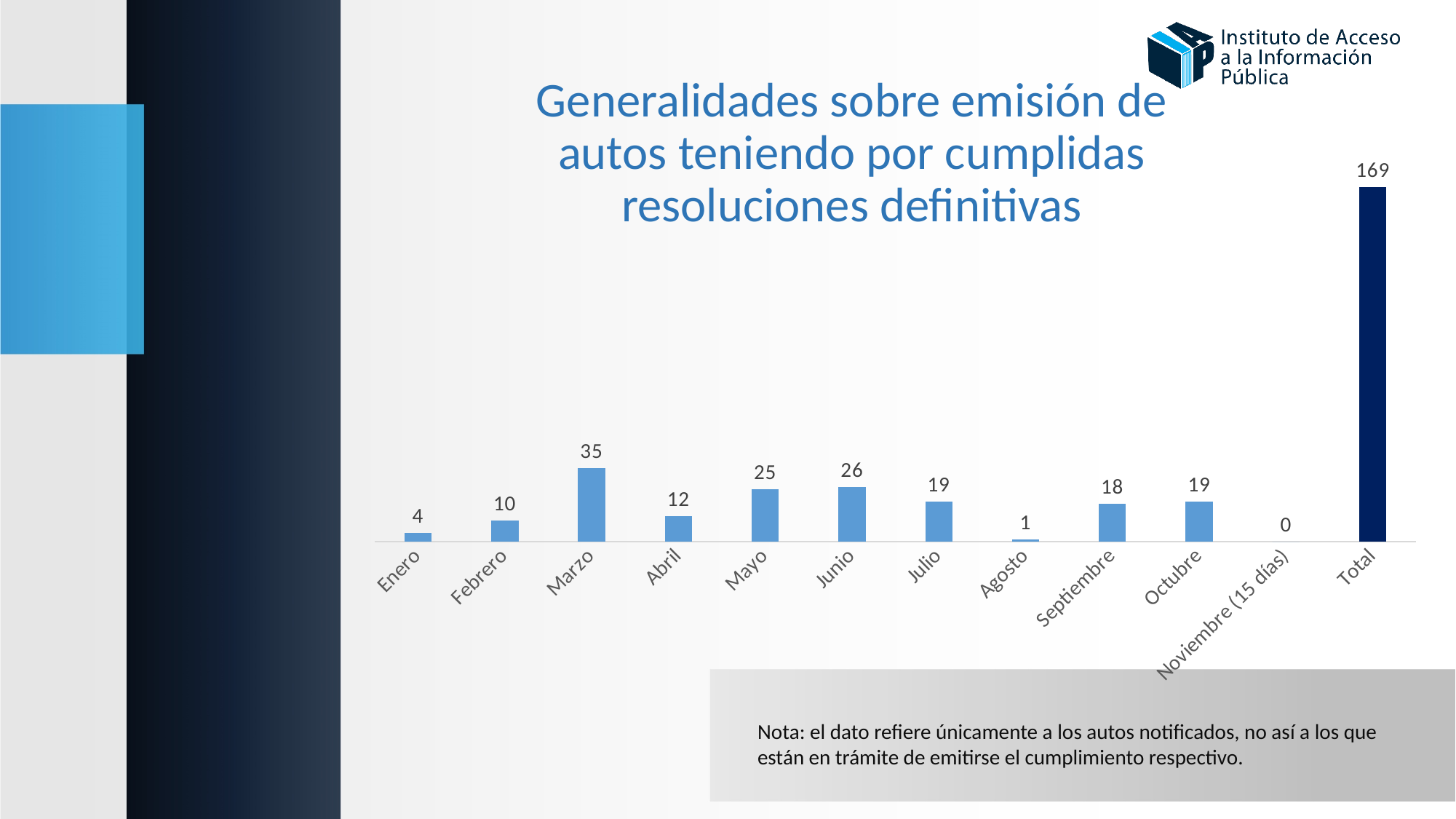
What is the value for Septiembre? 18 What is the value shown for Total? 169 What is the title of the chart? Generalidades sobre emisión de autos teniendo por cumplidas resoluciones definitivas What is the value for Marzo? 35 Which month has the lowest value? Noviembre (15 días) What is the value for Noviembre (15 días)? 0 What is the difference between the values for Junio and Abril? 14 Which is larger, the value for Mayo or the value for Julio? Mayo What kind of chart is shown on the slide? Bar chart Do the values rise or fall from Enero to Marzo? Rise How many categories are shown on the x axis, including Total? 12 Excluding the Total bar, which month has the highest value? Marzo